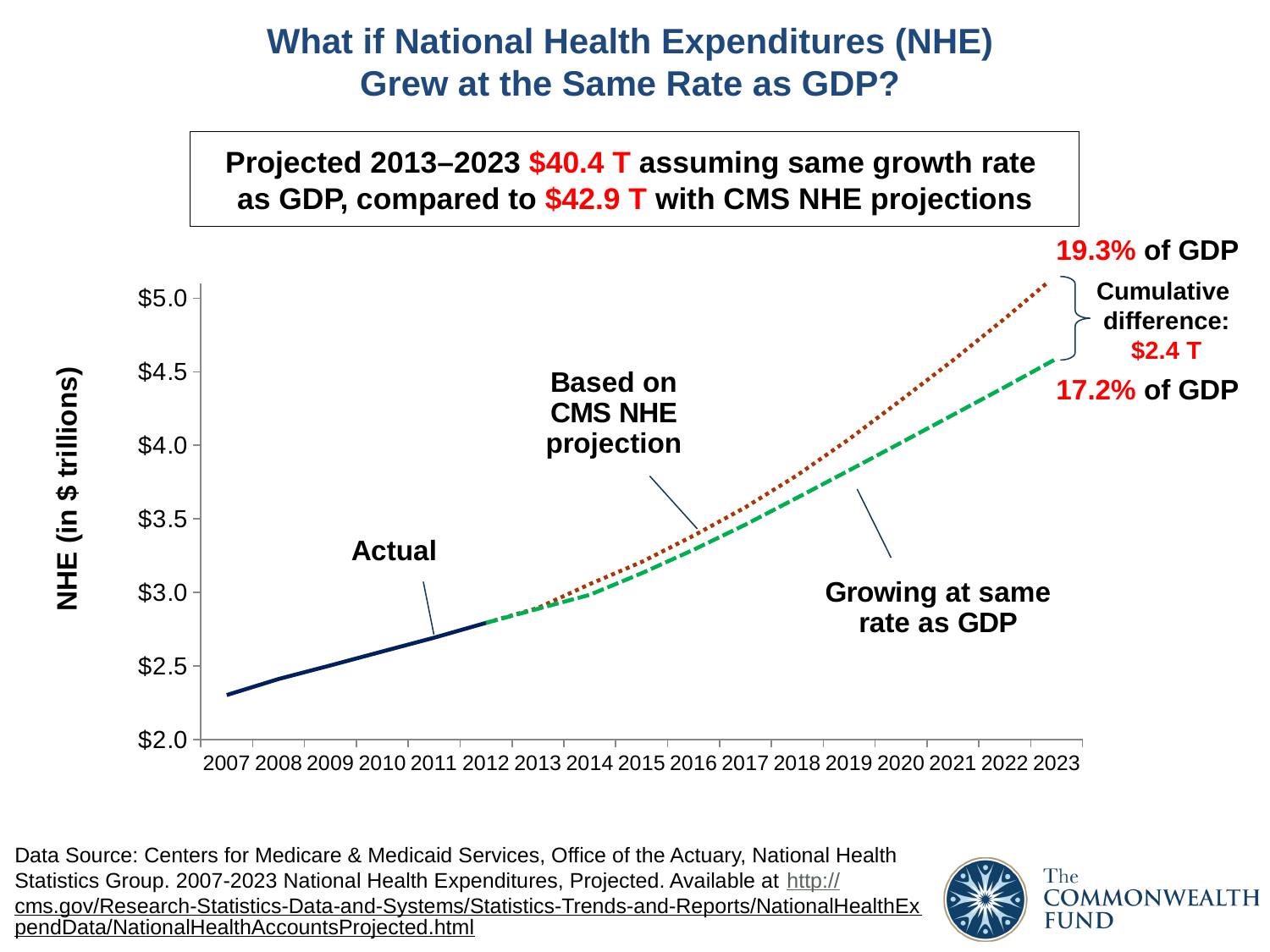
What kind of chart is shown on the slide? line chart What is the title of the chart on the slide? What if National Health Expenditures (NHE) Grew at the Same Rate as GDP? What share of GDP is labeled for the CMS NHE projection line in 2023? 19.3% Do NHE values rise or fall from 2007 to 2023 along the x axis? rise What cumulative difference between the two projections is labeled on the chart? $2.4 T In 2023, which line is higher: the CMS NHE projection or the line growing at the same rate as GDP? CMS NHE projection Is the actual NHE value for 2007 greater or less than $2.5 trillion? less Is the 2023 value of the CMS NHE projection line greater or less than $5.0 trillion? greater Is the actual NHE value for 2012 greater or less than $2.5 trillion? greater How many years are labeled along the x axis of the chart? 17 What is the projected 2013–2023 total NHE assuming the same growth rate as GDP, according to the text box? $40.4 T